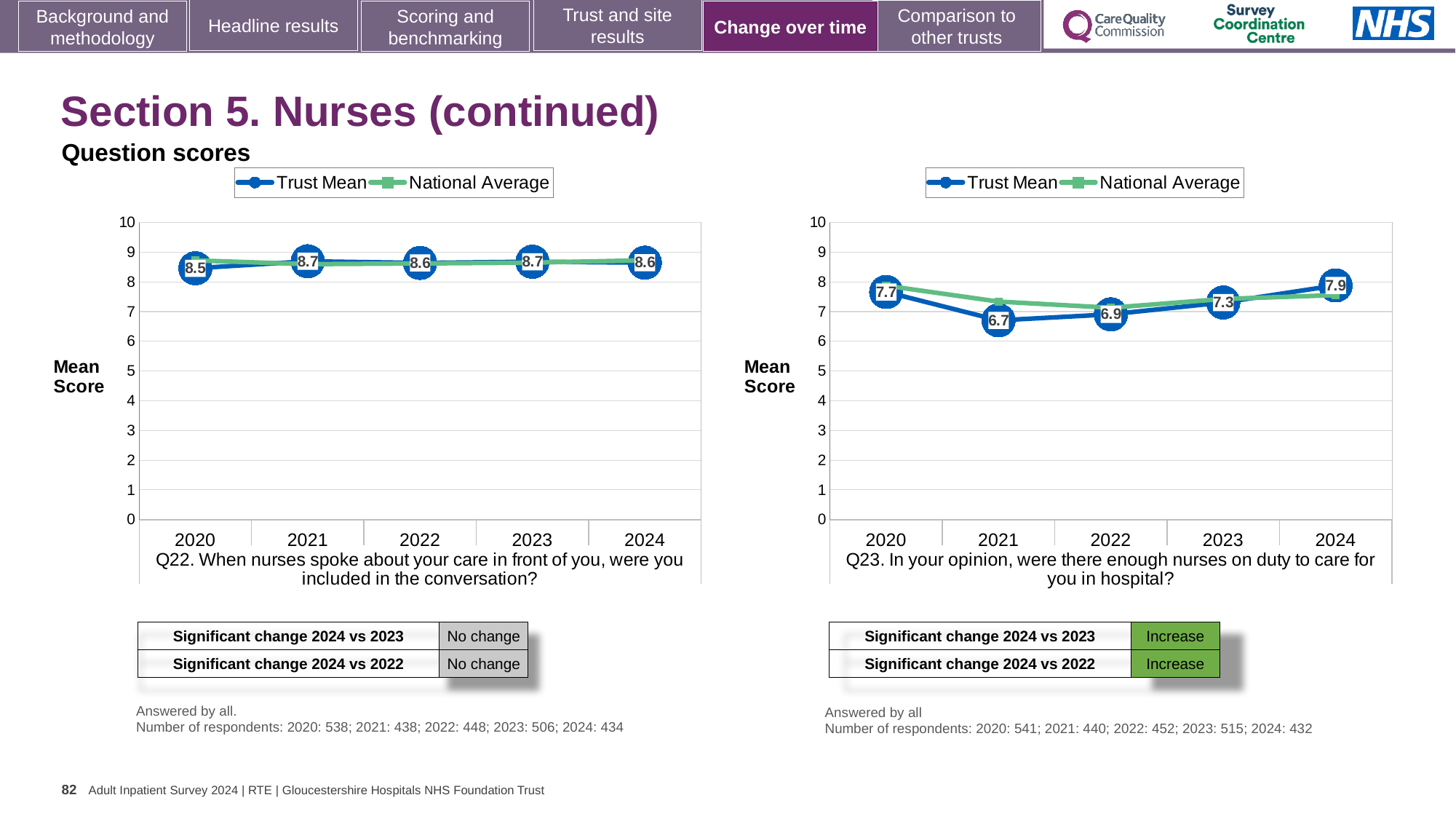
In the Q22 chart on the left, is the Trust Mean score for 2021 or 2020 higher? 2021 In the Q23 chart on the right, is the Trust Mean value for 2022 greater or less than 7? less What type of chart is the Q22 chart on the left? Line chart In the Q23 chart on the right, which year has the highest Trust Mean score? 2024 In the Q23 chart on the right, which year has the lowest Trust Mean score? 2021 In the Q23 chart on the right, what is the difference between the Trust Mean scores for 2024 and 2021? 1.2 In the Q22 chart on the left, what is the Trust Mean score for 2024? 8.6 How many years are plotted on the x axis of the Q22 chart on the left? 5 In the Q22 chart on the left, what is the Trust Mean score for 2020? 8.5 In the Q23 chart on the right, what is the Trust Mean score for 2024? 7.9 How many series does the legend of the Q23 chart on the right list? 2 In the Q23 chart on the right, what is the Trust Mean score for 2021? 6.7